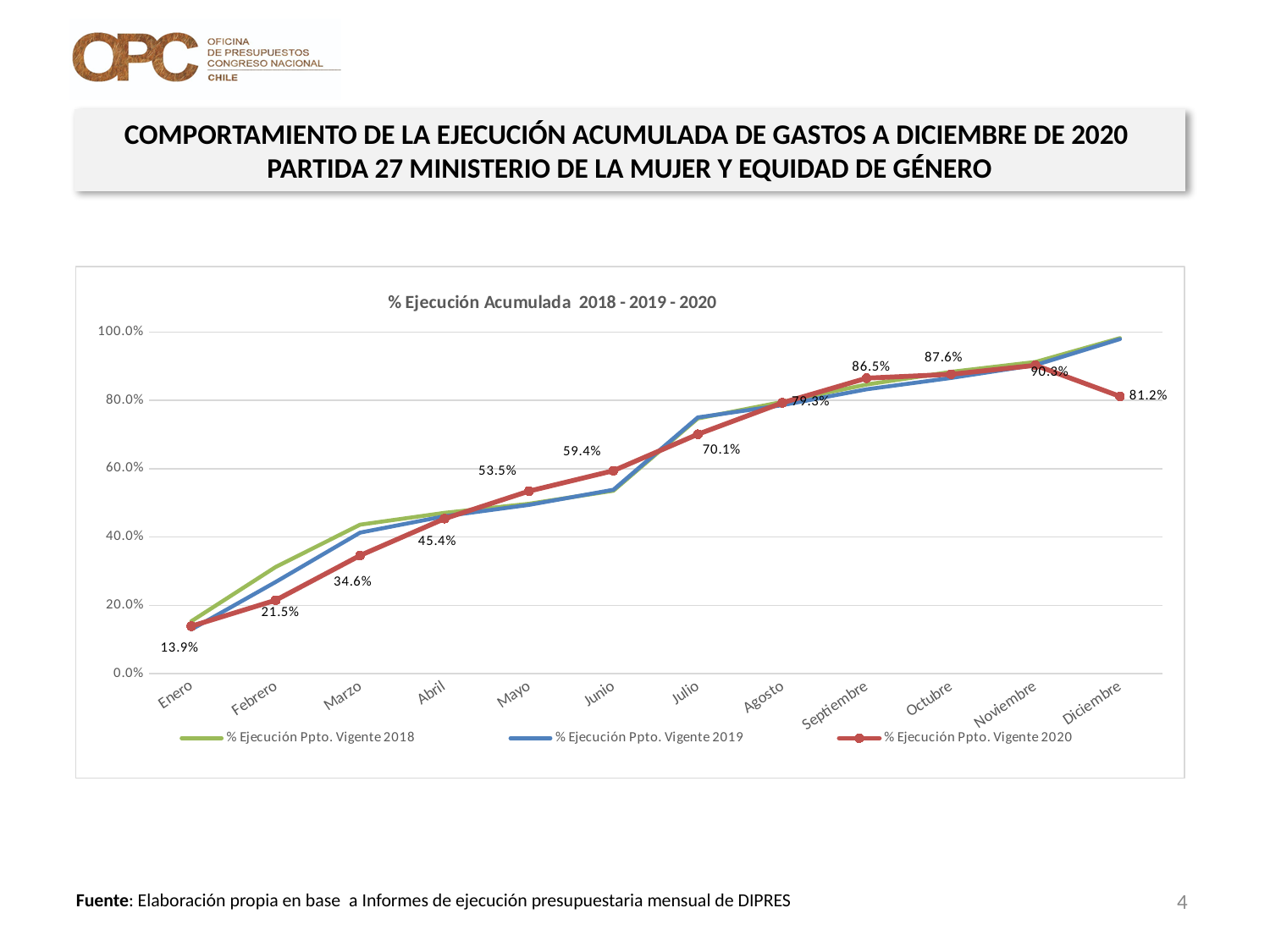
Is the value for % Ejecución Ppto. Vigente 2020 in Marzo greater or less than 40.0%? less What is the value for % Ejecución Ppto. Vigente 2020 in Enero? 13.9% What is the value for % Ejecución Ppto. Vigente 2020 in Junio? 59.4% Which series has the lowest value in Diciembre? % Ejecución Ppto. Vigente 2020 What type of chart is shown on the slide? line chart Is the value for % Ejecución Ppto. Vigente 2019 in Diciembre greater or less than 80.0%? greater What is the value for % Ejecución Ppto. Vigente 2020 in Diciembre? 81.2% How many series does the legend list? 3 How many months are shown on the x axis? 12 What is the title of the chart? % Ejecución Acumulada 2018 - 2019 - 2020 What is the difference between the % Ejecución Ppto. Vigente 2020 values for Agosto and Julio? 9.2% What is the value for % Ejecución Ppto. Vigente 2020 in Octubre? 87.6%